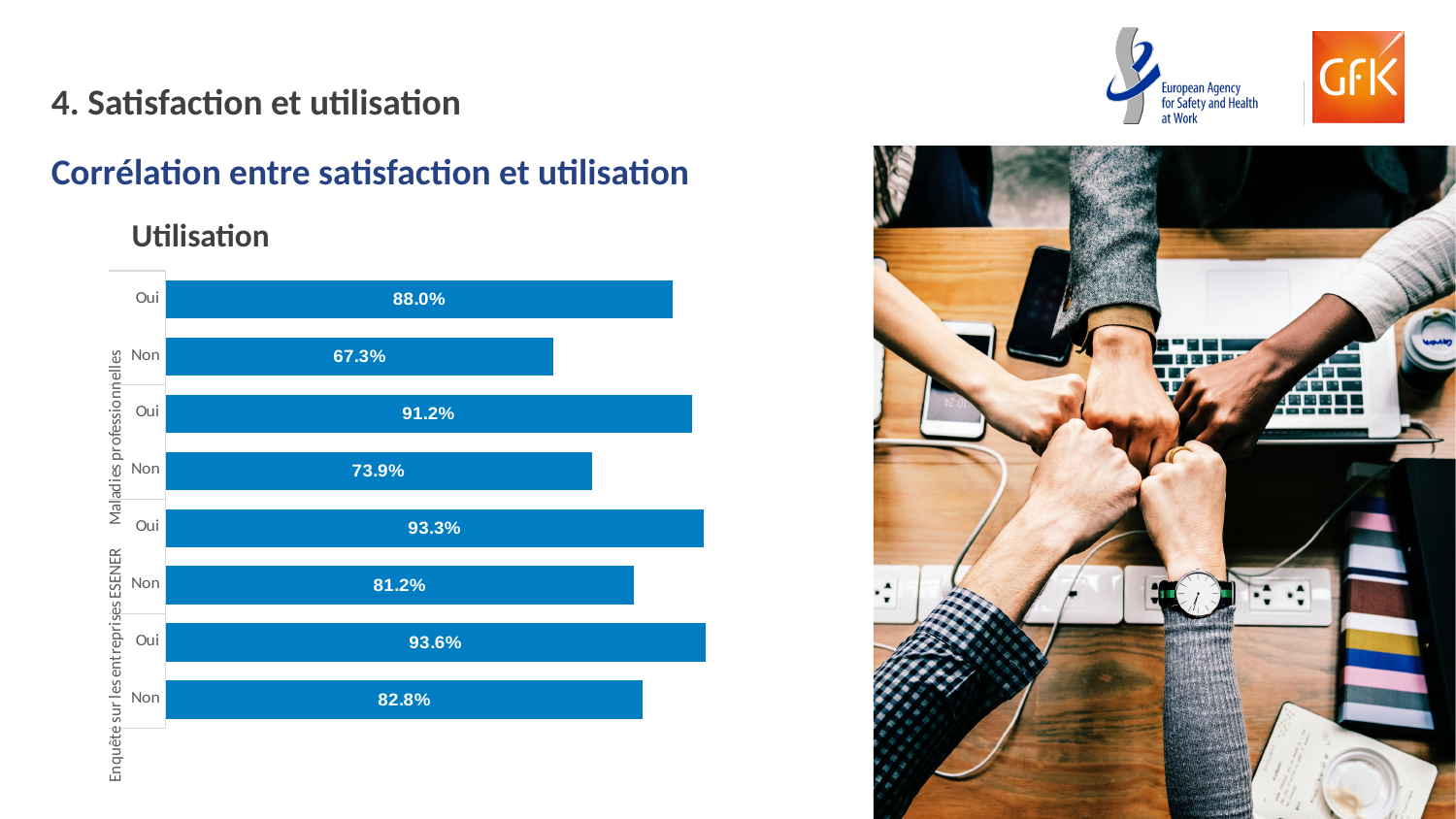
What is the value of the bottom bar (the last 'Non' bar)? 82.8% What is the value of the topmost bar (the first 'Oui' bar)? 88.0% What is the difference between the topmost 'Oui' bar (88.0%) and the 'Non' bar directly below it (67.3%)? 20.7 percentage points How many bars are plotted in the chart? 8 Which bar has the lowest value in the chart? the second bar from the top (Non, 67.3%) Which bar has the highest value in the chart? the seventh bar from the top (Oui, 93.6%) What is the difference between the fifth bar from the top (93.3%) and the sixth bar from the top (81.2%)? 12.1 percentage points What is the value of the second bar from the top (the first 'Non' bar)? 67.3% What is the title of the chart? Utilisation What is the value of the seventh bar from the top (the last 'Oui' bar)? 93.6% What type of chart is shown on the slide? bar chart Which is larger: the third bar from the top (91.2%) or the fourth bar from the top (73.9%)? the third bar (91.2%)